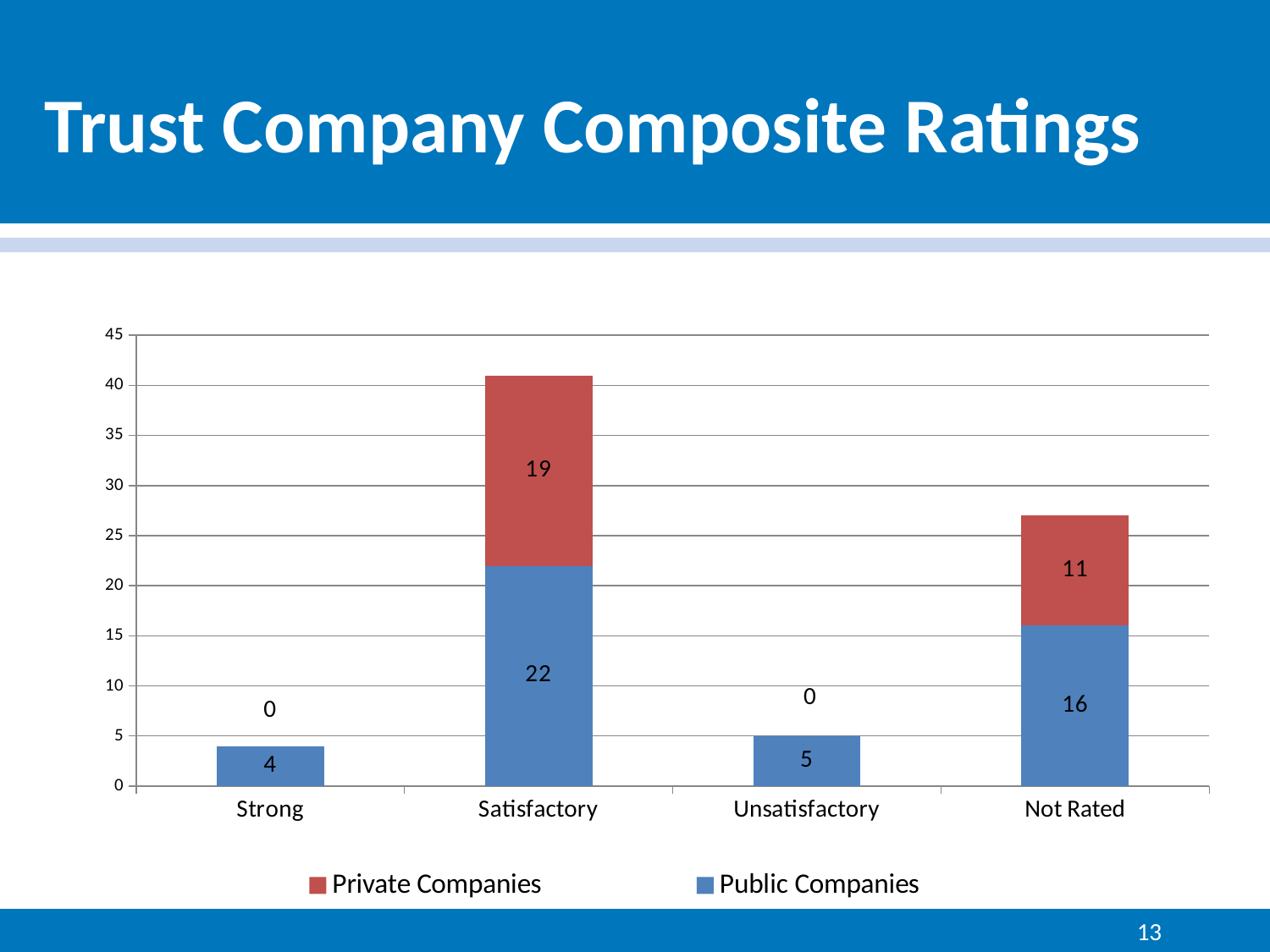
What is the difference between Public Companies and Private Companies in the Not Rated category? 5 Which category has the lowest value for Public Companies? Strong How many series does the legend list? 2 Which is larger: Private Companies in Satisfactory or Private Companies in Not Rated? Private Companies in Satisfactory What is the value for Private Companies in the Not Rated category? 11 What is the value for Public Companies in the Satisfactory category? 22 Which category has the highest value for Public Companies? Satisfactory What is the value for Private Companies in the Strong category? 0 How many categories are shown on the x axis? 4 What is the value for Public Companies in the Unsatisfactory category? 5 What is the total of the stacked bar for Satisfactory? 41 What is the total of the stacked bar for Not Rated? 27